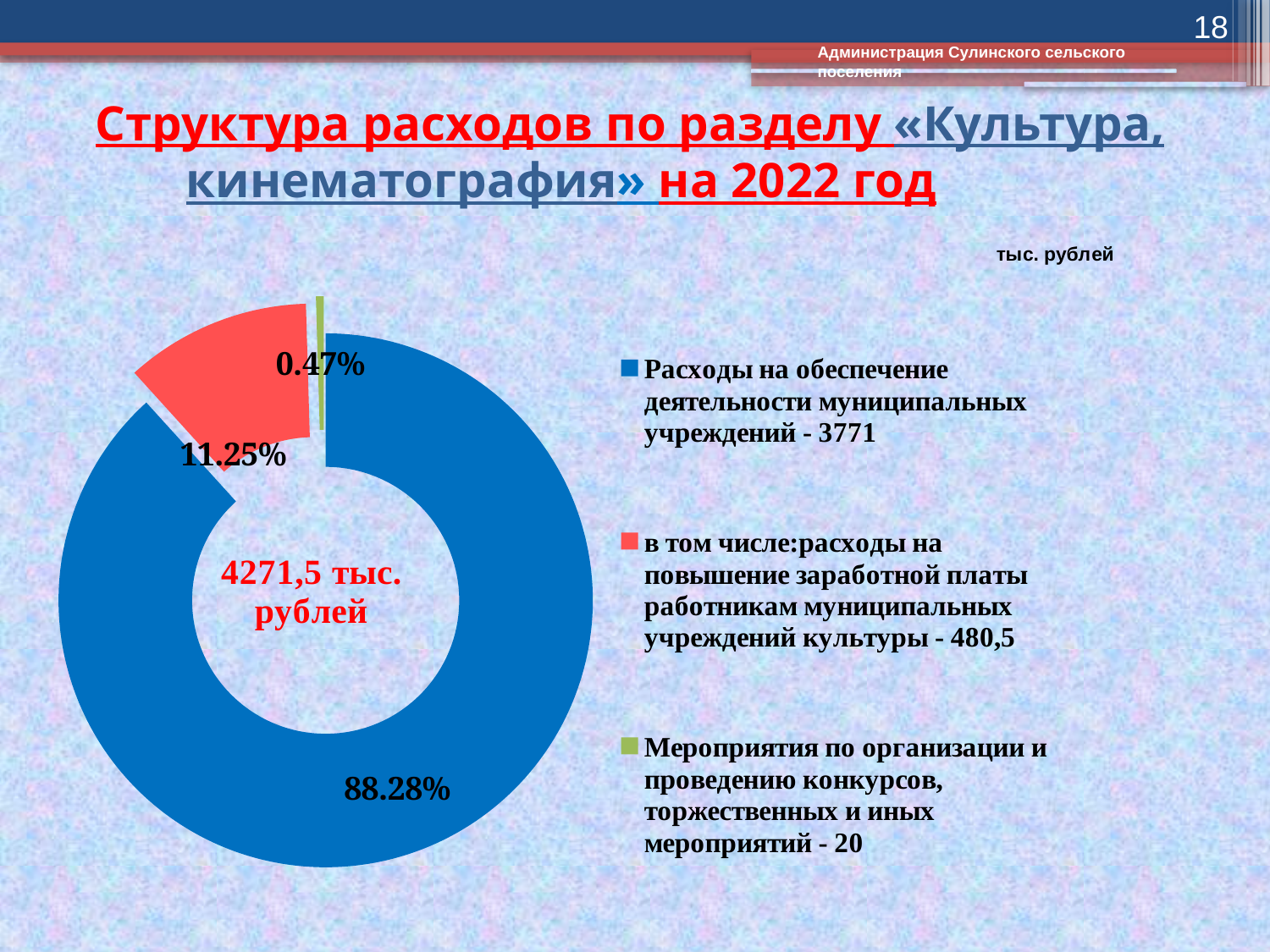
How many slices does the doughnut chart have? 3 What value is given in the legend for Мероприятия по организации и проведению конкурсов, торжественных и иных мероприятий? 20 What share of the doughnut chart is labelled for the blue slice (Расходы на обеспечение деятельности муниципальных учреждений)? 88.28% How many entries does the legend list? 3 What share of the doughnut chart is labelled for the green slice (Мероприятия по организации и проведению конкурсов, торжественных и иных мероприятий)? 0.47% Which category has the largest slice of the doughnut chart? Расходы на обеспечение деятельности муниципальных учреждений What value is given in the legend for Расходы на обеспечение деятельности муниципальных учреждений? 3771 What share of the doughnut chart is labelled for the red slice (расходы на повышение заработной платы работникам муниципальных учреждений культуры)? 11.25% What total amount is shown in the centre of the doughnut chart? 4271,5 тыс. рублей Which category has the smallest slice of the doughnut chart? Мероприятия по организации и проведению конкурсов, торжественных и иных мероприятий What value is given in the legend for расходы на повышение заработной платы работникам муниципальных учреждений культуры? 480,5 What type of chart is shown on the slide? doughnut chart